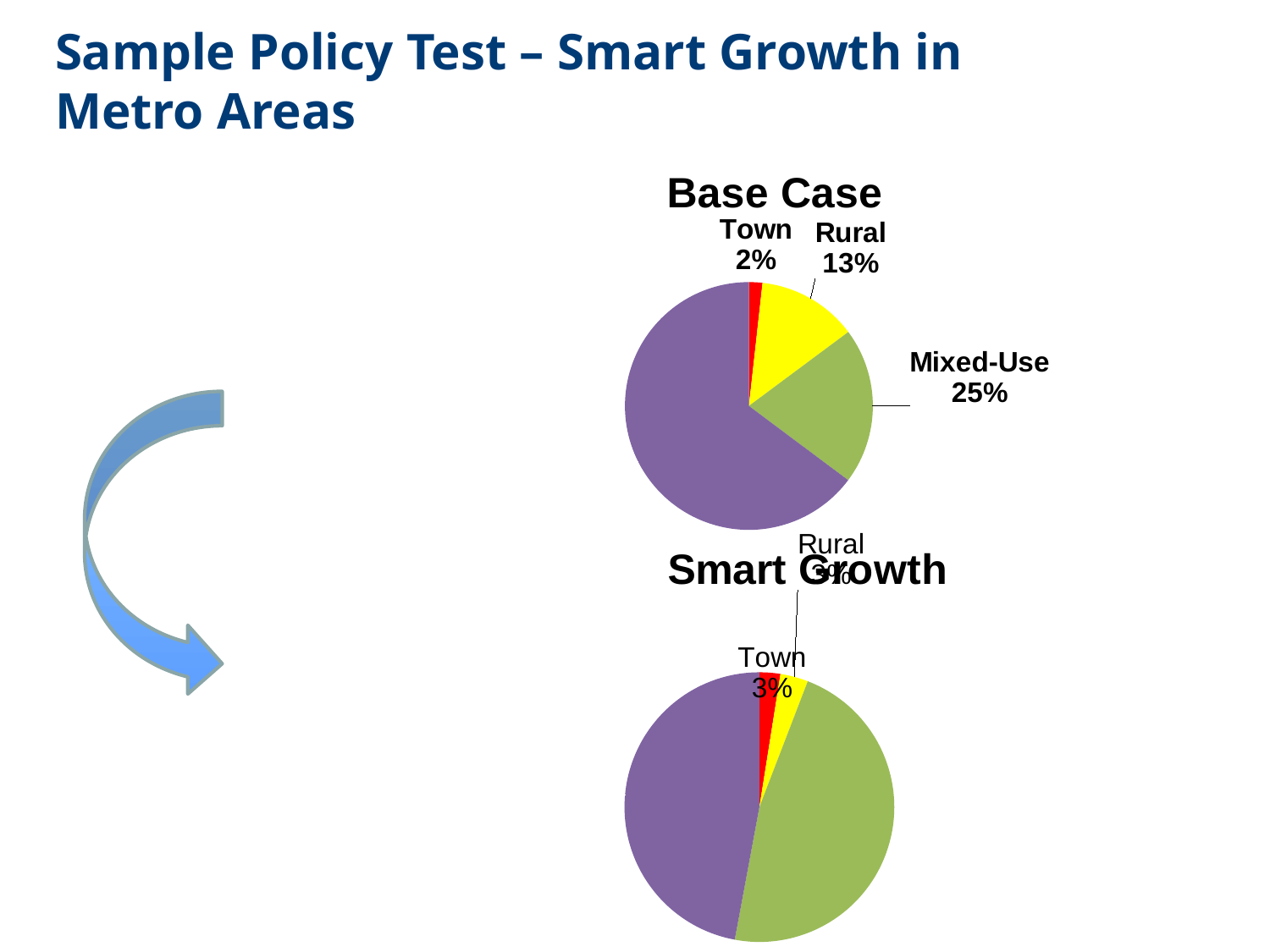
Is the Town share larger in the Base Case chart or the Smart Growth chart? Smart Growth In the Base Case chart, which slice is the smallest? Town In the Base Case chart, what is the difference between Rural and Town? 11% In the Base Case chart, what percentage is Town? 2% In the Smart Growth chart, what percentage is Town? 3% How many slices does the Base Case pie chart have? 4 In the Base Case chart, which is larger, Rural or Mixed-Use? Mixed-Use In the Base Case chart, what percentage is Rural? 13% What kind of chart is the Base Case chart? pie chart In the Base Case chart, what percentage is Mixed-Use? 25% In the Base Case chart, what is the difference between Mixed-Use and Rural? 12% What colour is the Town slice in the Base Case chart? red